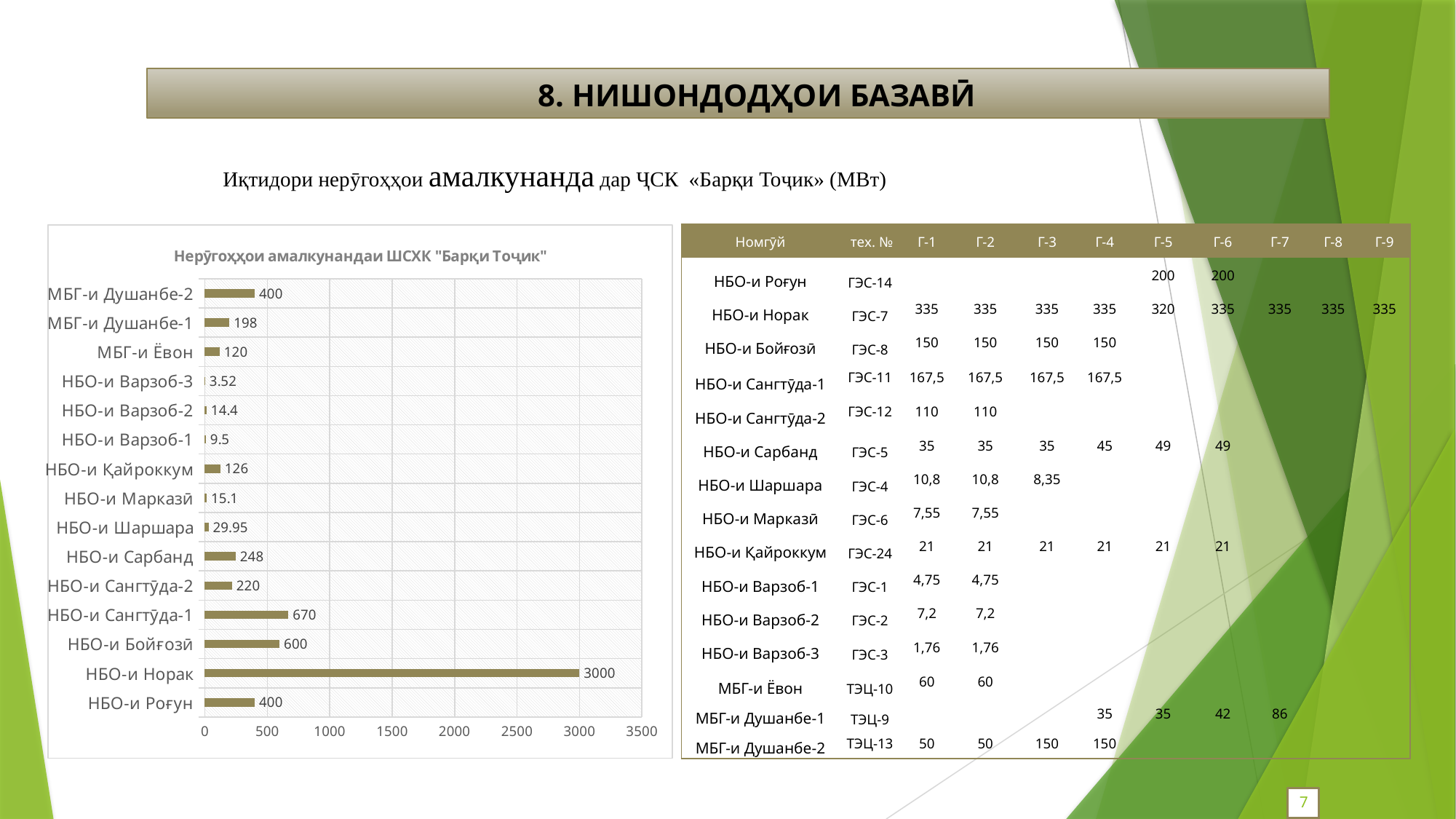
What is the value for НБО-и Шаршара? 29.95 What is the difference between the values for НБО-и Сангтӯда-1 and НБО-и Бойғозӣ? 70 How many categories are shown in the chart? 15 Which is larger, the value for НБО-и Сарбанд or НБО-и Сангтӯда-2? НБО-и Сарбанд What is the difference between the values for НБО-и Норак and НБО-и Сангтӯда-1? 2330 What is the value for НБО-и Норак? 3000 Is the value for НБО-и Бойғозӣ greater or less than 500? greater What is the value for МБГ-и Душанбе-1? 198 What kind of chart is shown on the slide? bar chart What is the value for НБО-и Сангтӯда-1? 670 Which category has the lowest value? НБО-и Варзоб-3 Which category has the highest value? НБО-и Норак